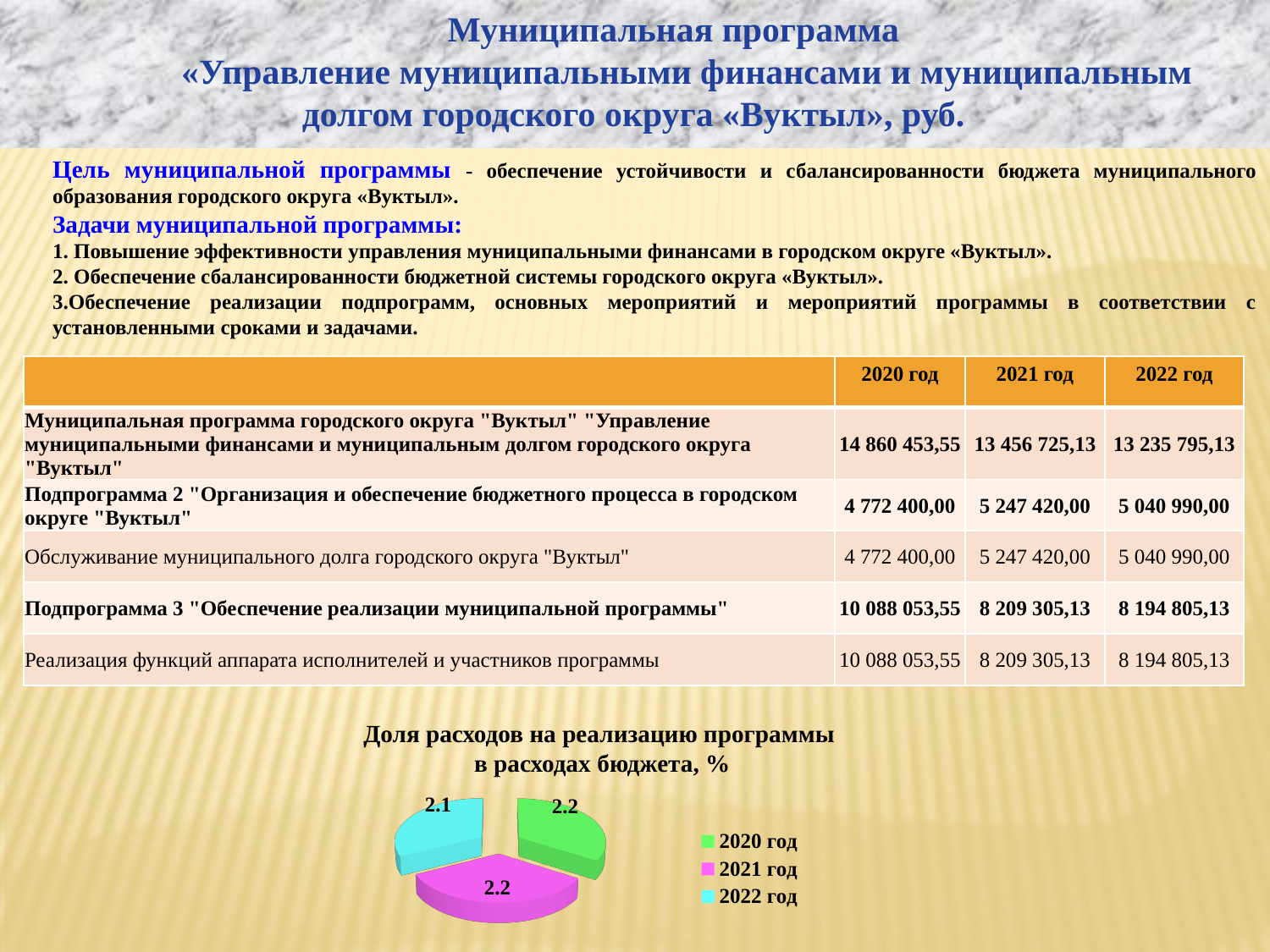
How many entries does the legend of the pie chart list? 3 What is the value shown for 2021 год in the pie chart? 2.2 What is the value shown for 2022 год in the pie chart? 2.1 What is the title of the pie chart? Доля расходов на реализацию программы в расходах бюджета, % What is the value shown for 2020 год in the pie chart? 2.2 Which colour represents 2021 год in the pie chart? magenta (pink) What is the difference between the values for 2020 год and 2022 год in the pie chart? 0.1 How many slices does the pie chart have? 3 What kind of chart is shown on the slide? pie chart Which is larger in the pie chart, the value for 2020 год or for 2022 год? 2020 год Which year has the smallest slice in the pie chart? 2022 год